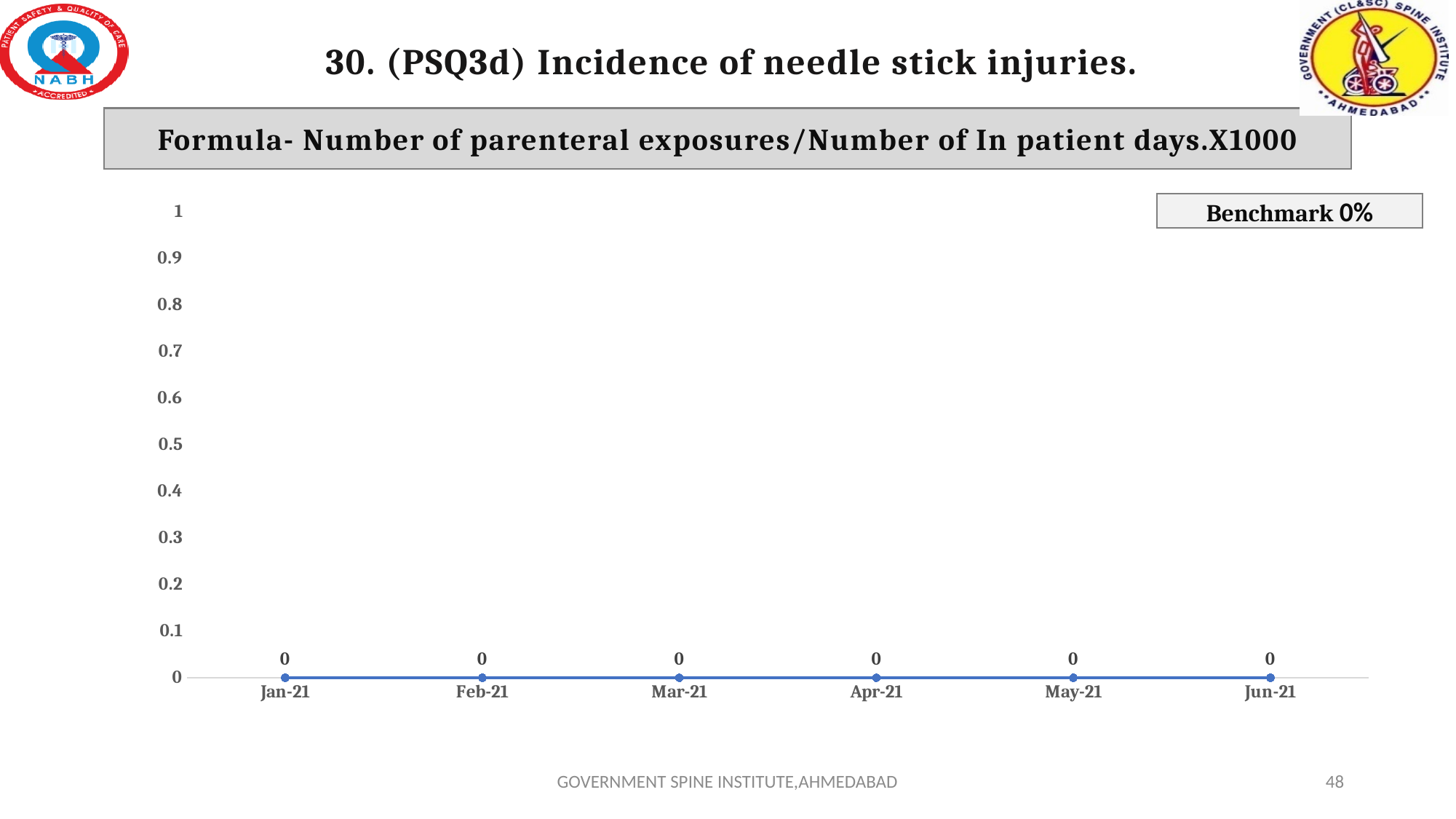
What kind of chart is shown on the slide? line chart Is the value for Feb-21 greater or less than 0.5? less Do the values rise, fall, or stay flat from Jan-21 to Jun-21? stay flat What benchmark is stated on the slide? 0% What is the value for Jan-21? 0 What is the value for Apr-21? 0 What is the difference between the values for Mar-21 and May-21? 0 Is the value for Jun-21 greater or less than 0.1? less What is the value for Jun-21? 0 How many months are plotted on the x axis? 6 What is the highest value shown on the y axis? 1